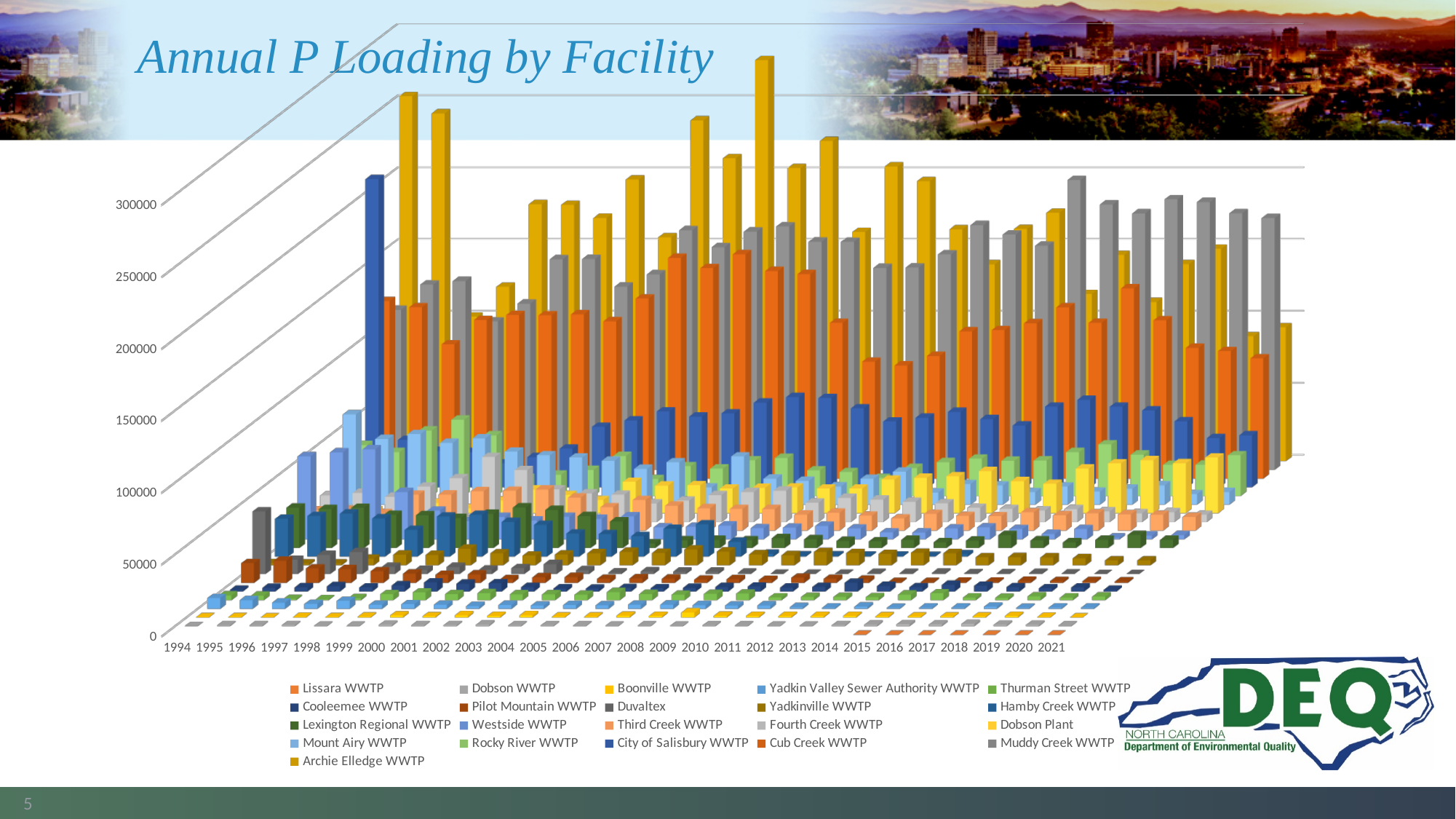
Which facility has the tallest bar in the chart? Archie Elledge WWTP What is the last year shown on the x axis? 2021 What is the highest value labelled on the vertical axis? 300000 What is the interval between the labelled ticks on the vertical axis? 50000 What kind of chart is shown on the slide? bar chart How many years are shown along the x axis? 28 What is the title of the chart? Annual P Loading by Facility How many facilities (series) does the legend list? 21 In which year does the tallest bar in the chart occur? 2005 Which facility is listed last in the legend? Archie Elledge WWTP What is the first year shown on the x axis? 1994